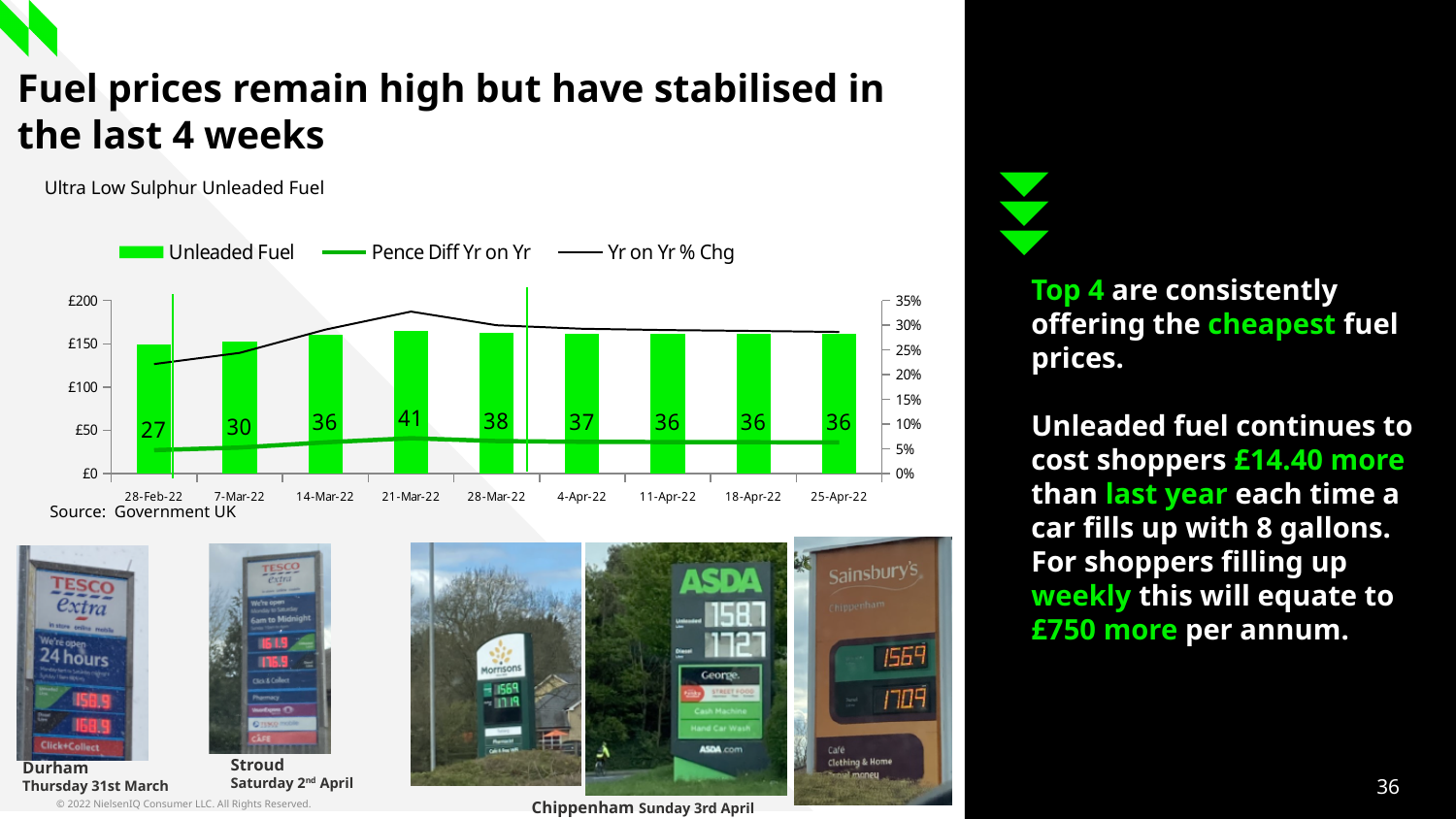
Which week has the highest labelled Pence Diff Yr on Yr value? 21-Mar-22 What is the Pence Diff Yr on Yr value labelled for 28-Feb-22? 27 Which is larger, the Pence Diff Yr on Yr value for 7-Mar-22 or for 28-Mar-22? 28-Mar-22 How many weekly dates are shown on the x axis? 9 Which week has the lowest labelled Pence Diff Yr on Yr value? 28-Feb-22 What is the Pence Diff Yr on Yr value labelled for 21-Mar-22? 41 How many series does the legend list? 3 Is the Unleaded Fuel bar for 21-Mar-22 greater or less than £150? greater What is the difference between the Pence Diff Yr on Yr values for 21-Mar-22 and 28-Feb-22? 14 Does the Pence Diff Yr on Yr value rise or fall from 28-Feb-22 to 21-Mar-22? rise Is the Yr on Yr % Chg value for 28-Feb-22 greater or less than 30%? less What is the Pence Diff Yr on Yr value labelled for 25-Apr-22? 36